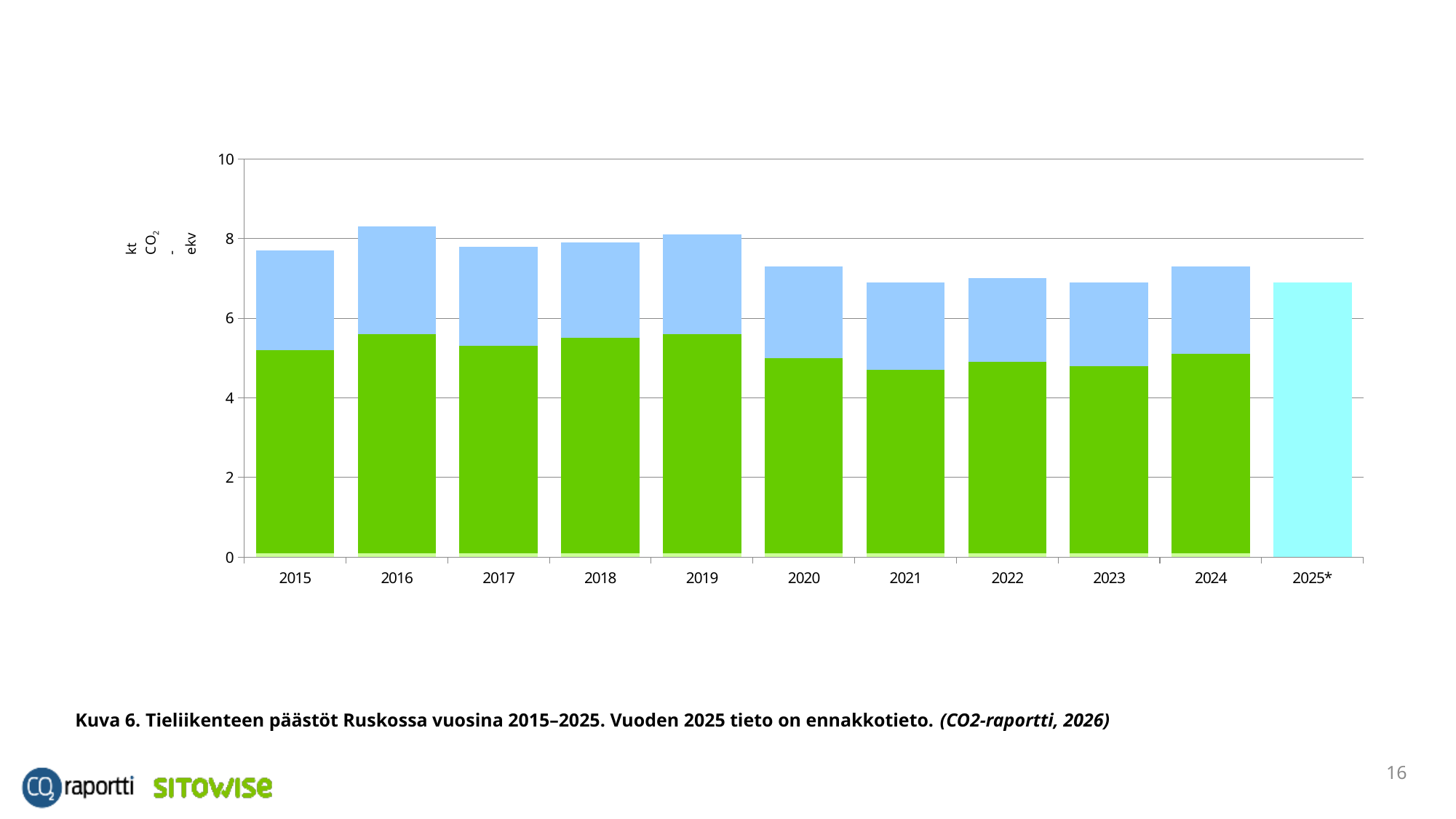
What kind of chart is shown on the slide? Stacked bar chart Is the total value of the bar for 2021 greater or less than 8? less Is the green segment of the bar for 2019 greater or less than 6? less Is the total value of the bar for 2016 greater or less than 8? greater Which has the larger total bar, 2016 or 2021? 2016 Which year has the highest total bar in the chart? 2016 What unit is shown on the y axis of the chart? kt CO2-ekv Do the total bar values generally rise or fall from 2015 to 2025*? fall How many years (categories) are shown on the x axis of the chart? 11